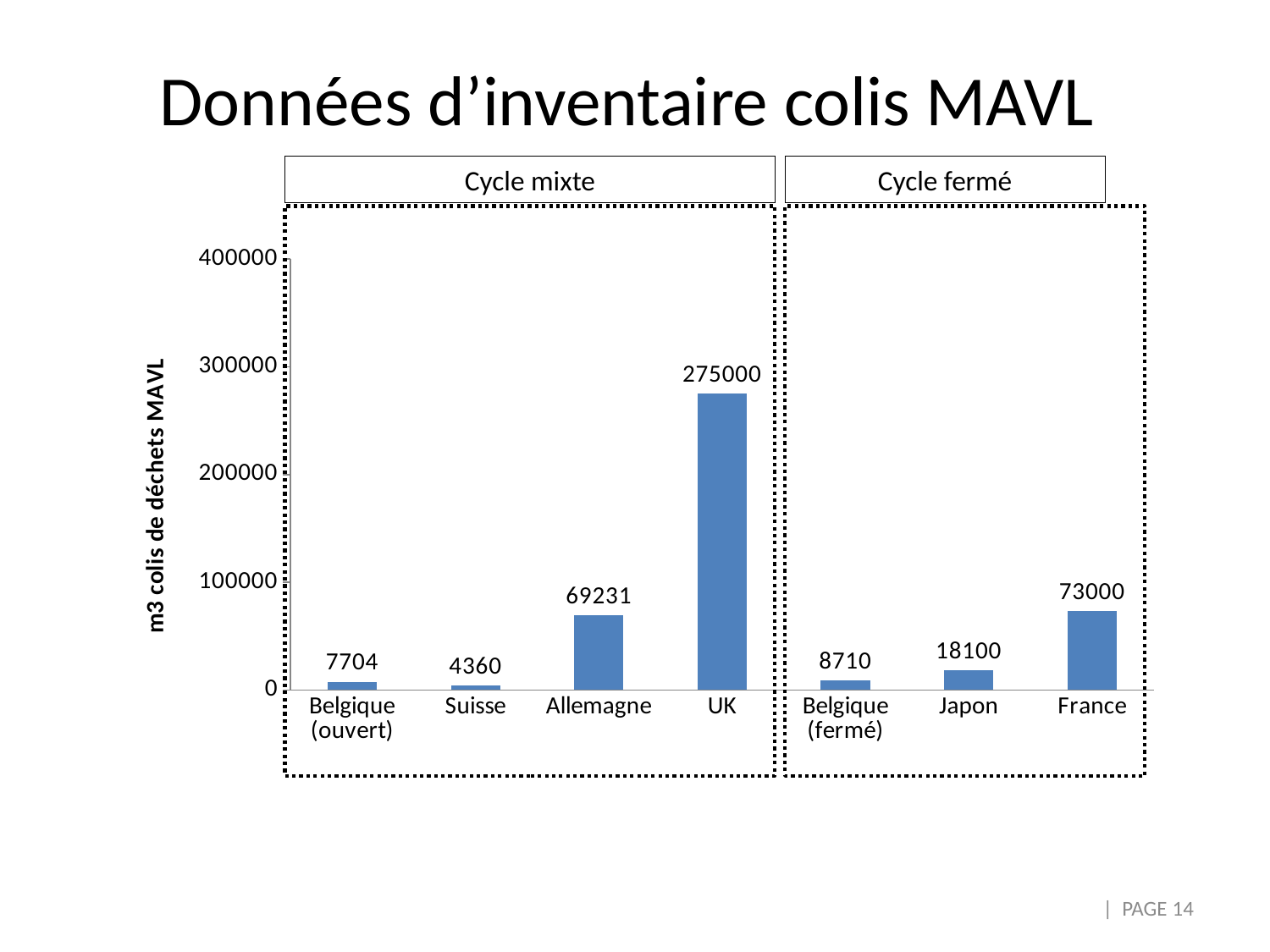
What is the value for UK? 275000 What is the value for Suisse? 4360 What is the label of the vertical axis? m3 colis de déchets MAVL What is the value for Belgique (fermé)? 8710 Is the value for Allemagne greater or less than 100000? less What is the difference between the values for France and Allemagne? 3769 What kind of chart is shown on the slide? bar chart Which category has the highest value? UK Which is larger, the value for Belgique (ouvert) or the value for Belgique (fermé)? Belgique (fermé) What is the value for Japon? 18100 How many categories are shown on the chart? 7 Which category has the lowest value? Suisse